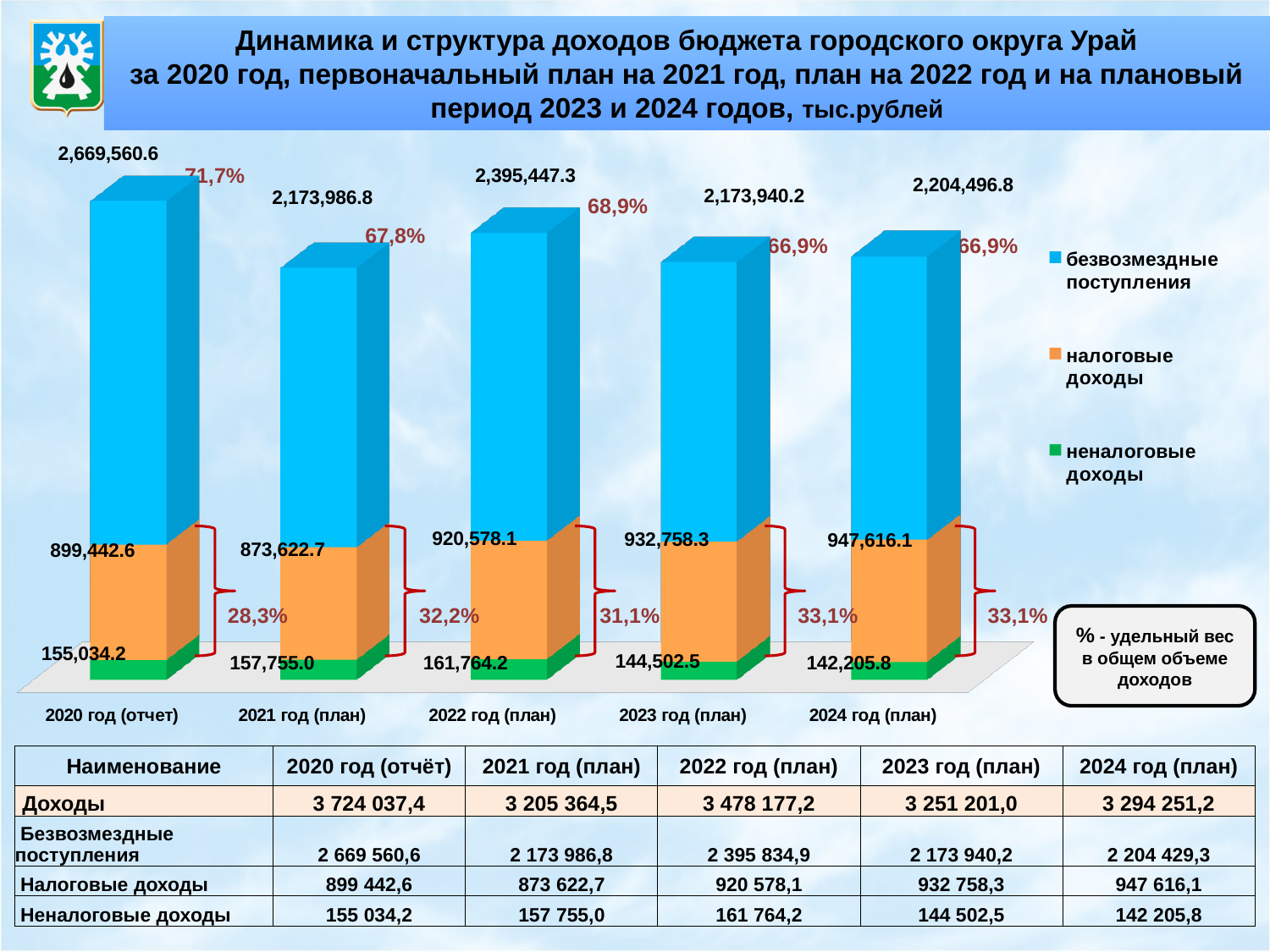
What is the value for неналоговые доходы in 2022 год (план)? 161,764.2 What is the difference between the налоговые доходы values for 2024 год (план) and 2020 год (отчет)? 48,173.5 Which is larger, the безвозмездные поступления value for 2022 год (план) or for 2023 год (план)? 2022 год (план) What percentage share is shown for безвозмездные поступления in 2021 год (план)? 67,8% In which year is the value for безвозмездные поступления the highest? 2020 год (отчет) How many years (categories) are shown on the x axis of the chart? 5 In which year is the value for неналоговые доходы the lowest? 2024 год (план) What kind of chart is shown on the slide? stacked bar chart What is the total of the stacked bar for 2020 год (отчет)? 3,724,037.4 What is the value for безвозмездные поступления in 2020 год (отчет)? 2,669,560.6 What is the value for налоговые доходы in 2023 год (план)? 932,758.3 How many series does the chart legend list? 3